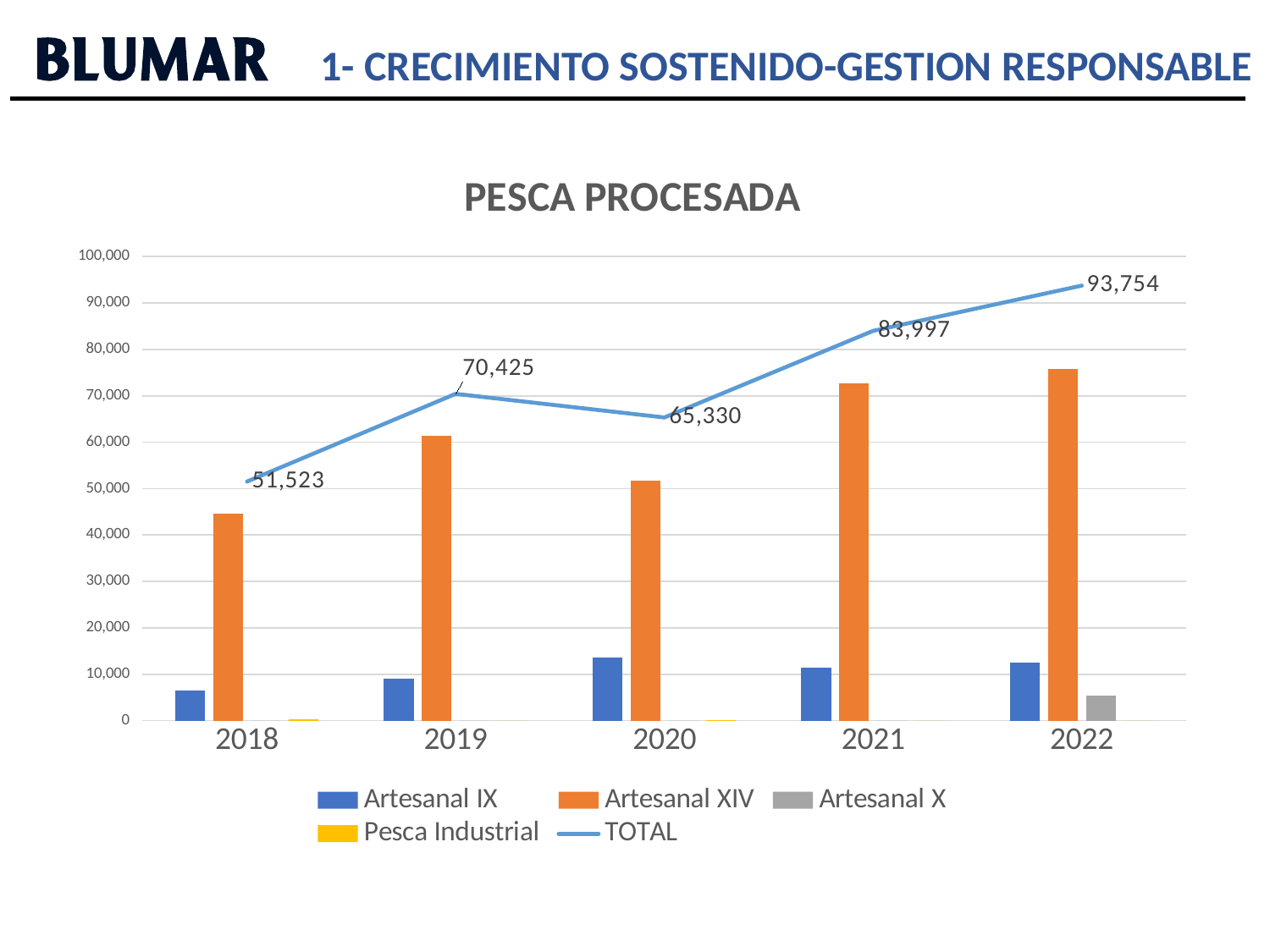
How many years are shown on the x axis? 5 In which year is the TOTAL lowest? 2018 Is the value for Artesanal XIV in 2018 greater or less than 50,000? less What kind of chart is shown on the slide? Combined bar and line chart In which year is the TOTAL highest? 2022 How many series does the legend list? 5 What is the TOTAL value for 2018? 51,523 What is the difference between the TOTAL for 2022 and the TOTAL for 2021? 9,757 By how much did the TOTAL fall from 2019 to 2020? 5,095 What is the TOTAL value for 2020? 65,330 Which year has the larger TOTAL, 2019 or 2020? 2019 What is the TOTAL value for 2022? 93,754